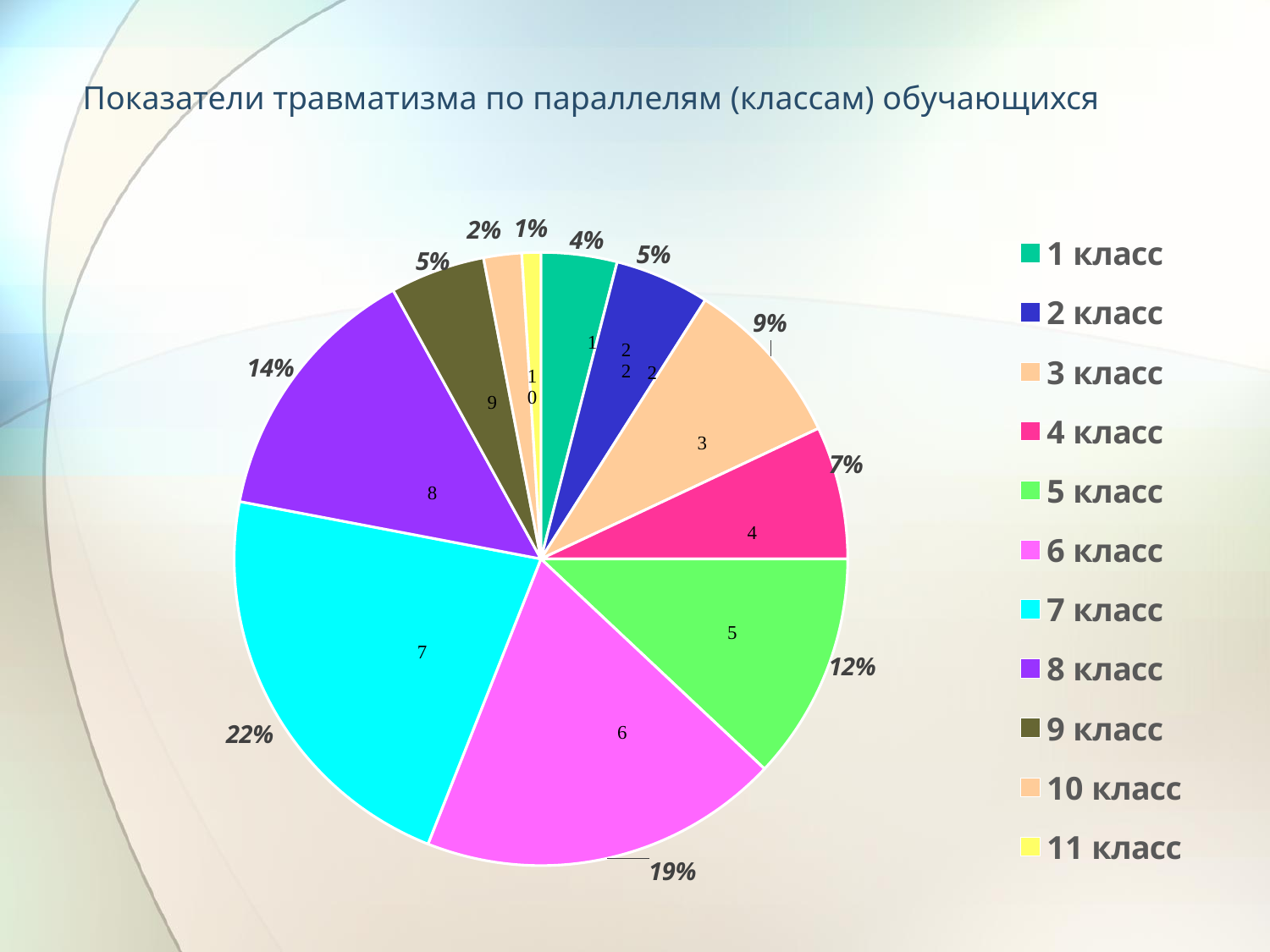
What is the difference in percentage points between the shares of 8 класс and 1 класс? 10 What share of the pie does 10 класс have? 2% What is the title of the chart? Показатели травматизма по параллелям (классам) обучающихся What share of the pie does 5 класс have? 12% What share of the pie does 11 класс have? 1% Which class has the smallest slice of the pie? 11 класс Which has a larger share, 3 класс or 4 класс? 3 класс Which class has the largest slice of the pie? 7 класс How many categories (classes) does the legend list? 11 What type of chart is shown on the slide? pie chart